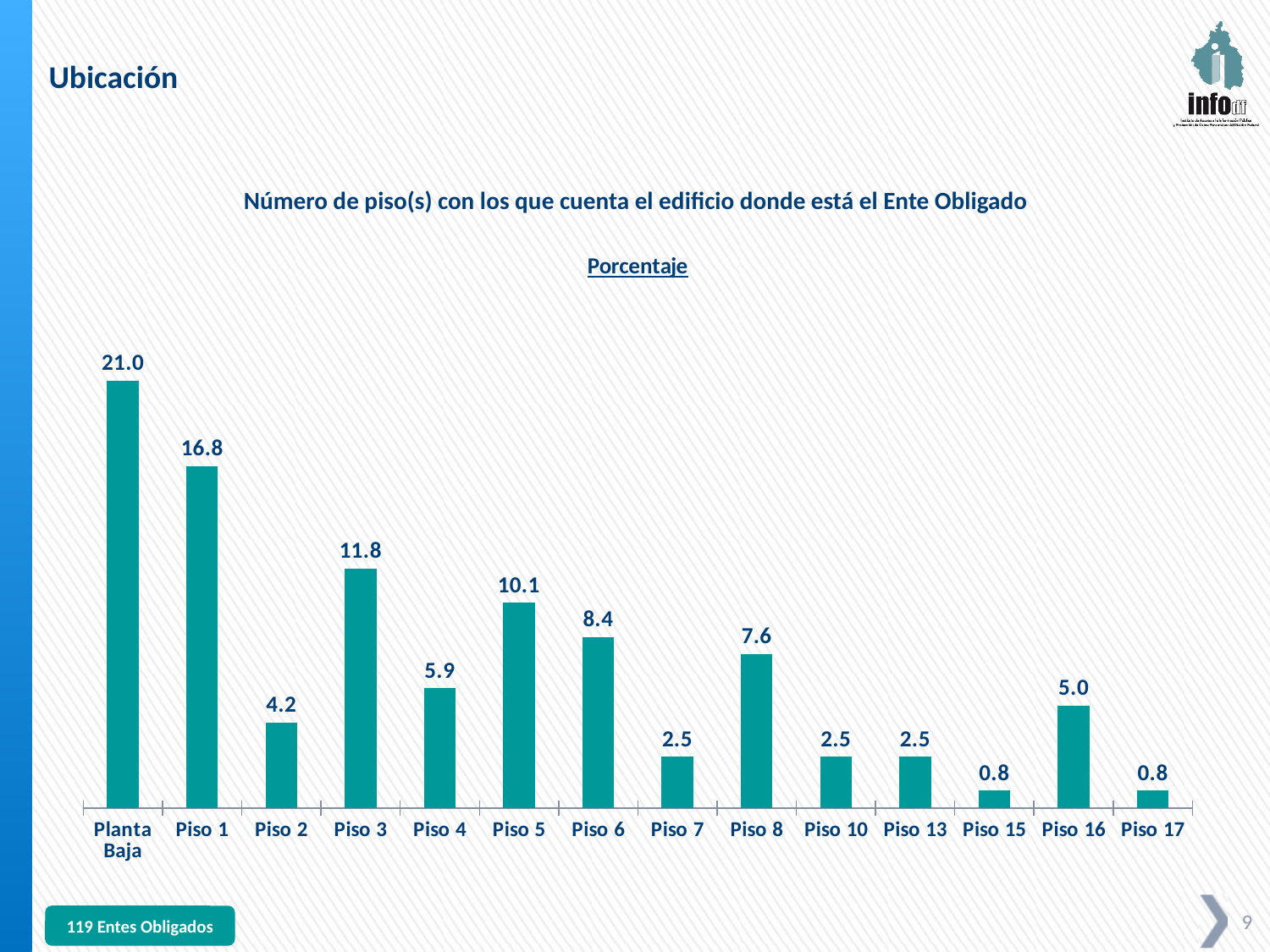
What kind of chart is this? Bar chart Which category has the highest value? Planta Baja What is the value for Planta Baja? 21.0 Which category has the lowest value, Piso 15 or Piso 16? Piso 15 Which is larger, the value for Piso 4 or the value for Piso 8? Piso 8 What is the value for Piso 16? 5.0 How many categories have a value of 2.5? 3 What is the title of the chart? Porcentaje What is the difference between the values for Planta Baja and Piso 1? 4.2 What is the difference between the values for Piso 5 and Piso 6? 1.7 What is the value for Piso 3? 11.8 How many categories are shown on the x axis? 14